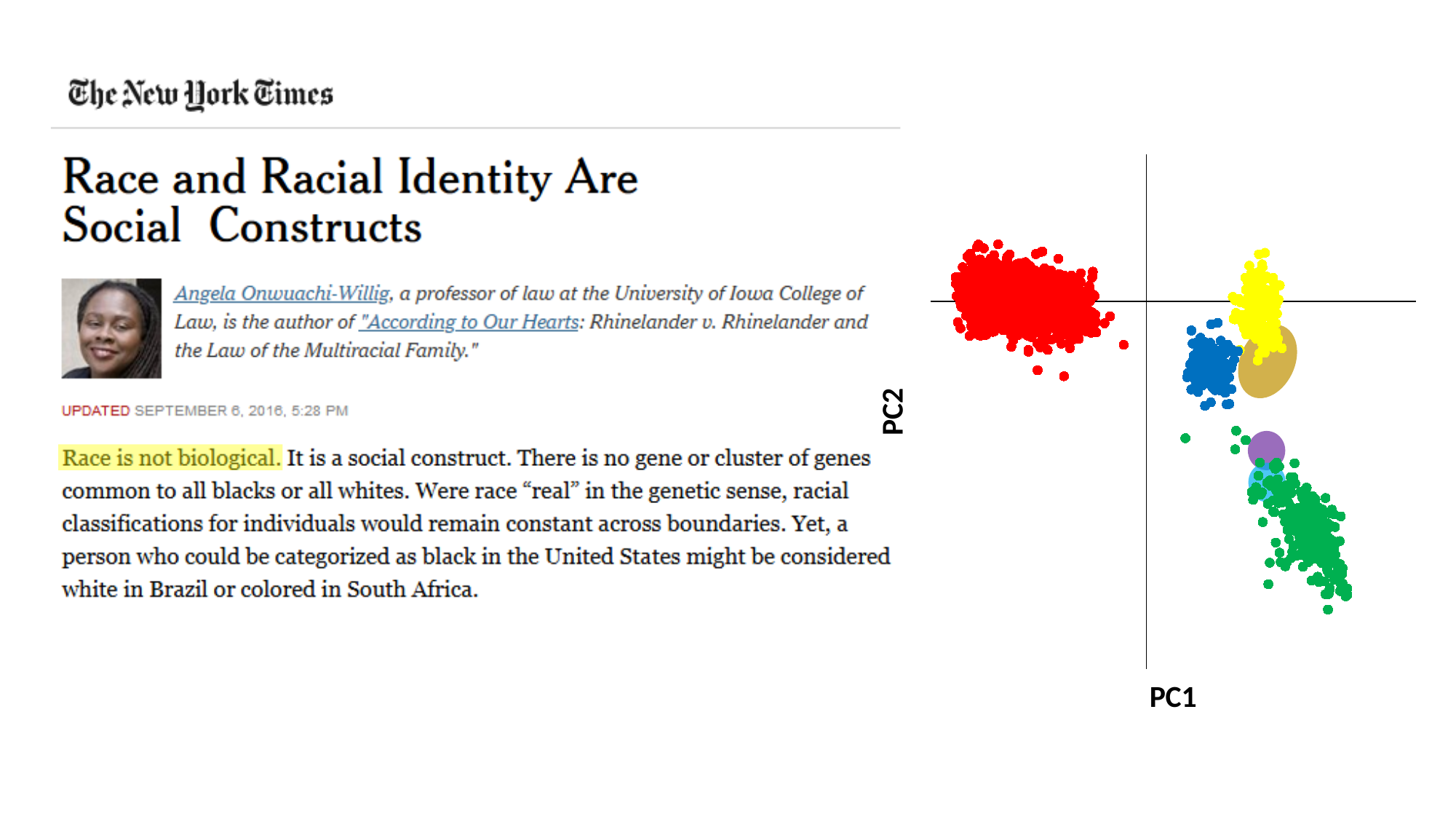
What is the label of the vertical axis of the scatter plot? PC2 In the scatter plot, which cluster is positioned higher on PC2, the yellow cluster or the green cluster? yellow What kind of chart is shown on the right side of the slide? scatter plot Which coloured cluster in the scatter plot lies entirely to the left of the vertical axis? red In the scatter plot, which cluster is positioned further right on PC1, the red cluster or the green cluster? green What is the label of the horizontal axis of the scatter plot? PC1 Which coloured cluster in the scatter plot extends lowest along the PC2 axis? green